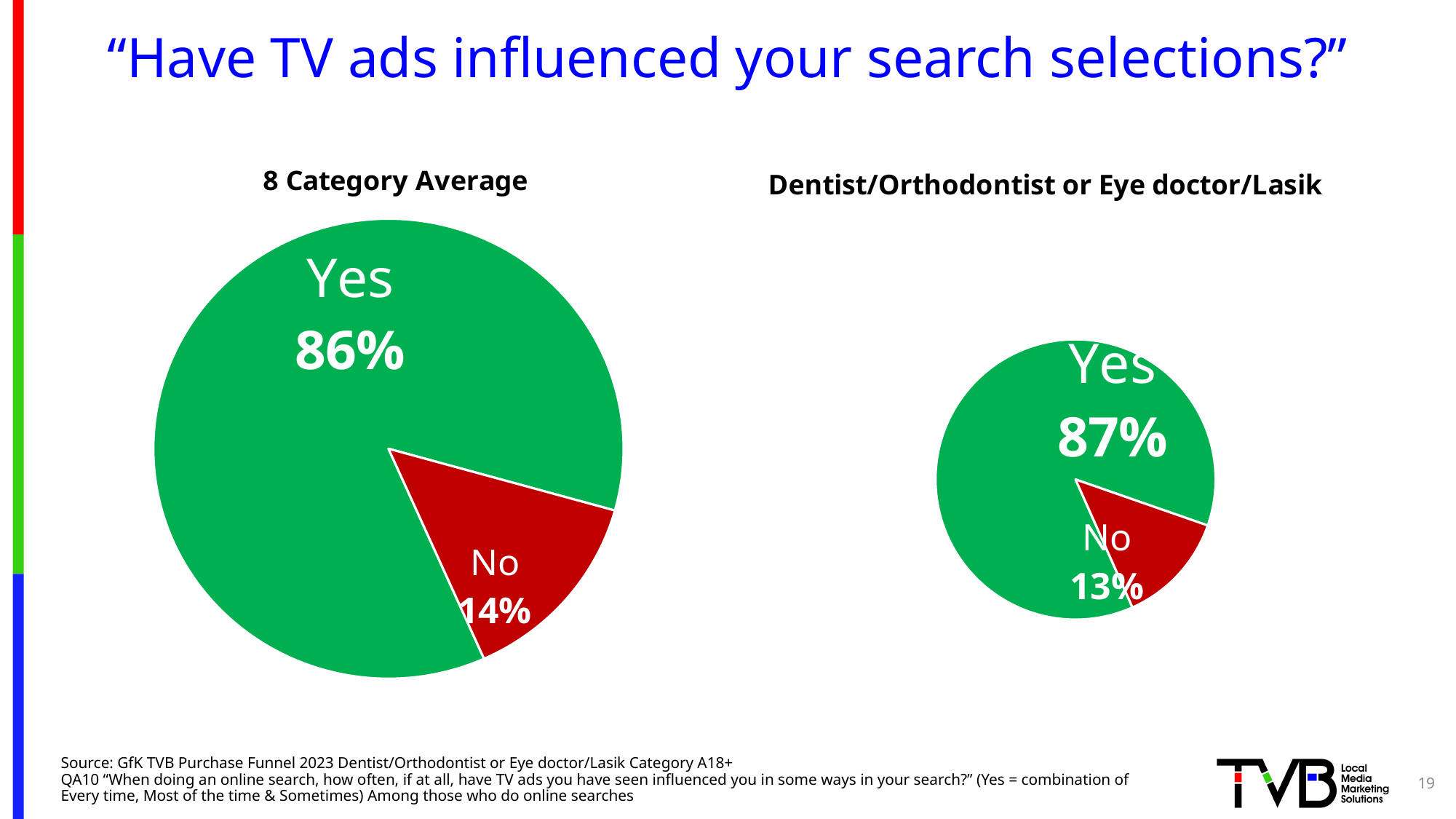
In the "Dentist/Orthodontist or Eye doctor/Lasik" pie chart, what percentage answered No? 13% In the "Dentist/Orthodontist or Eye doctor/Lasik" pie chart, what percentage answered Yes? 87% Is the Yes percentage larger in the "8 Category Average" chart or the "Dentist/Orthodontist or Eye doctor/Lasik" chart? Dentist/Orthodontist or Eye doctor/Lasik In the "8 Category Average" pie chart, which response has the largest share? Yes What colour is the Yes slice in the "8 Category Average" pie chart? Green In the "8 Category Average" pie chart, what percentage answered Yes? 86% In the "8 Category Average" pie chart, what is the difference between the Yes and No percentages? 72% What type of chart is used for the "8 Category Average"? Pie chart In the "8 Category Average" pie chart, what percentage answered No? 14% How many slices does the "Dentist/Orthodontist or Eye doctor/Lasik" pie chart have? 2 In the "Dentist/Orthodontist or Eye doctor/Lasik" pie chart, which response has the smallest share? No What is the title of the pie chart on the right side of the slide? Dentist/Orthodontist or Eye doctor/Lasik